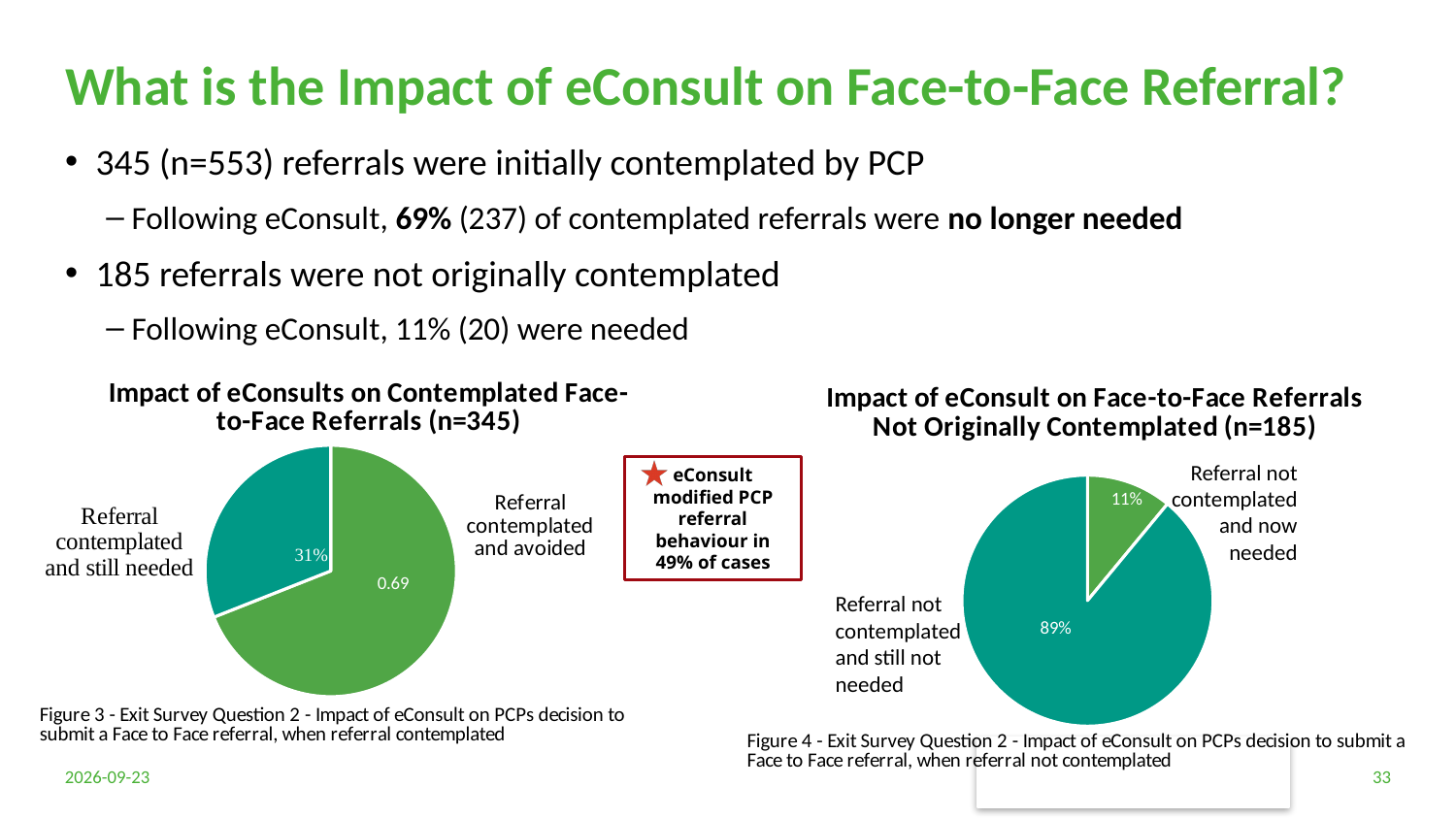
In the chart titled 'Impact of eConsult on Face-to-Face Referrals Not Originally Contemplated (n=185)', what share is shown for 'Referral not contemplated and still not needed'? 89% In the chart titled 'Impact of eConsults on Contemplated Face-to-Face Referrals (n=345)', what value is shown for 'Referral contemplated and still needed'? 31% What is the title of the pie chart on the right of the slide? Impact of eConsult on Face-to-Face Referrals Not Originally Contemplated (n=185) In the chart titled 'Impact of eConsult on Face-to-Face Referrals Not Originally Contemplated (n=185)', what is the difference in percentage points between the two slices? 78 In the chart titled 'Impact of eConsults on Contemplated Face-to-Face Referrals (n=345)', which is larger: 'Referral contemplated and avoided' or 'Referral contemplated and still needed'? Referral contemplated and avoided In the chart titled 'Impact of eConsults on Contemplated Face-to-Face Referrals (n=345)', which slice is the largest? Referral contemplated and avoided In the chart titled 'Impact of eConsults on Contemplated Face-to-Face Referrals (n=345)', what value is shown for 'Referral contemplated and avoided'? 0.69 How many slices does the chart titled 'Impact of eConsult on Face-to-Face Referrals Not Originally Contemplated (n=185)' have? 2 In the chart titled 'Impact of eConsult on Face-to-Face Referrals Not Originally Contemplated (n=185)', what share is shown for 'Referral not contemplated and now needed'? 11% How many pie charts are shown on the slide? 2 What kind of chart is the one on the left of the slide, titled 'Impact of eConsults on Contemplated Face-to-Face Referrals (n=345)'? Pie chart In the chart titled 'Impact of eConsult on Face-to-Face Referrals Not Originally Contemplated (n=185)', which slice is the smallest? Referral not contemplated and now needed